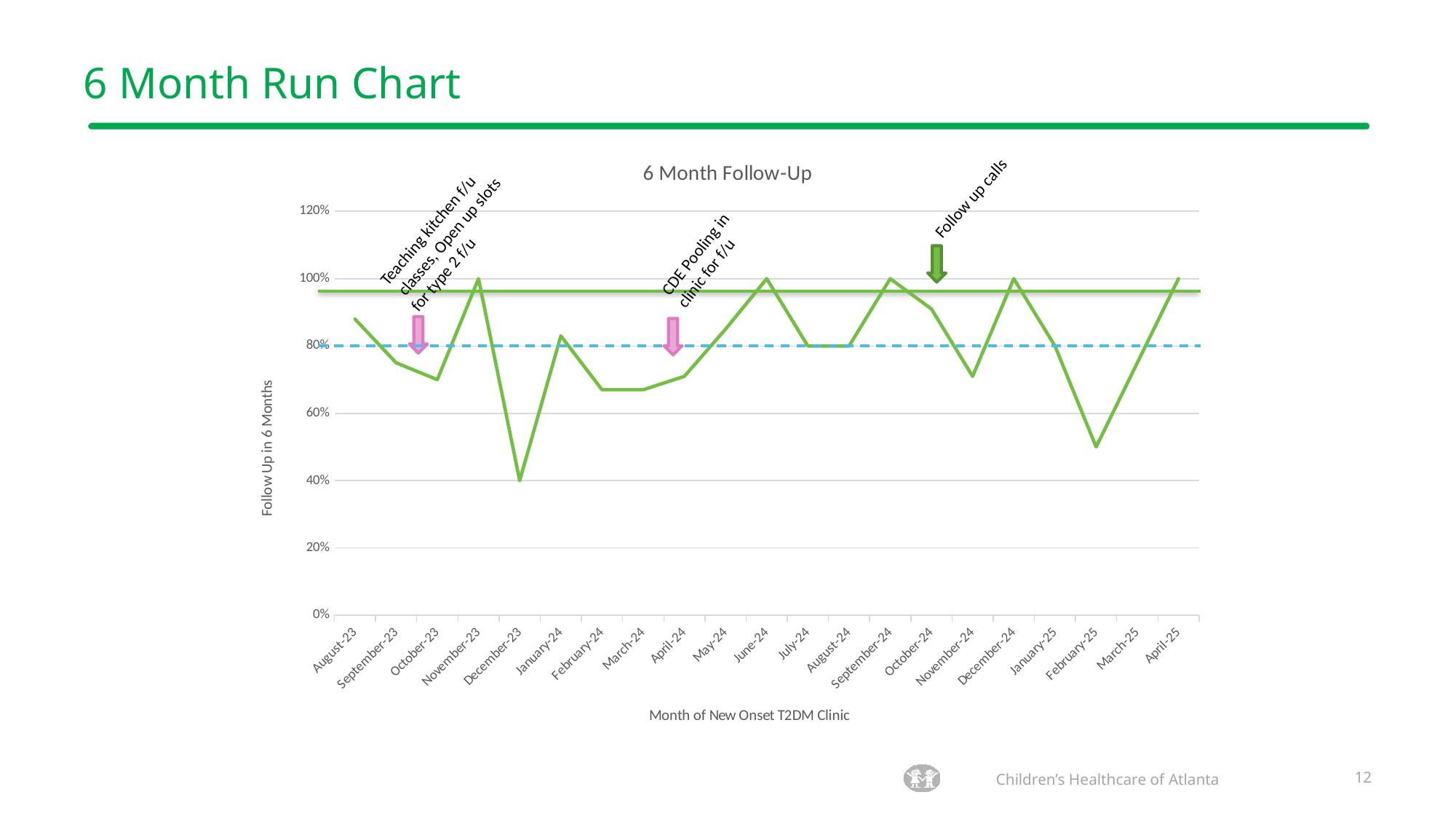
What is the follow-up value for July-24? 80% Is the value for February-25 greater or less than 60%? less Is the value for October-23 greater or less than 80%? less What is the follow-up value for December-23? 40% What is the follow-up value for November-23? 100% Which has the larger value, December-23 or February-25? February-25 What is the label of the x axis? Month of New Onset T2DM Clinic Do the values rise or fall from December-24 to February-25? fall How many months are plotted along the x axis? 21 What type of chart is shown on the slide? line chart What is the title of the chart? 6 Month Follow-Up Which month has the lowest follow-up value? December-23